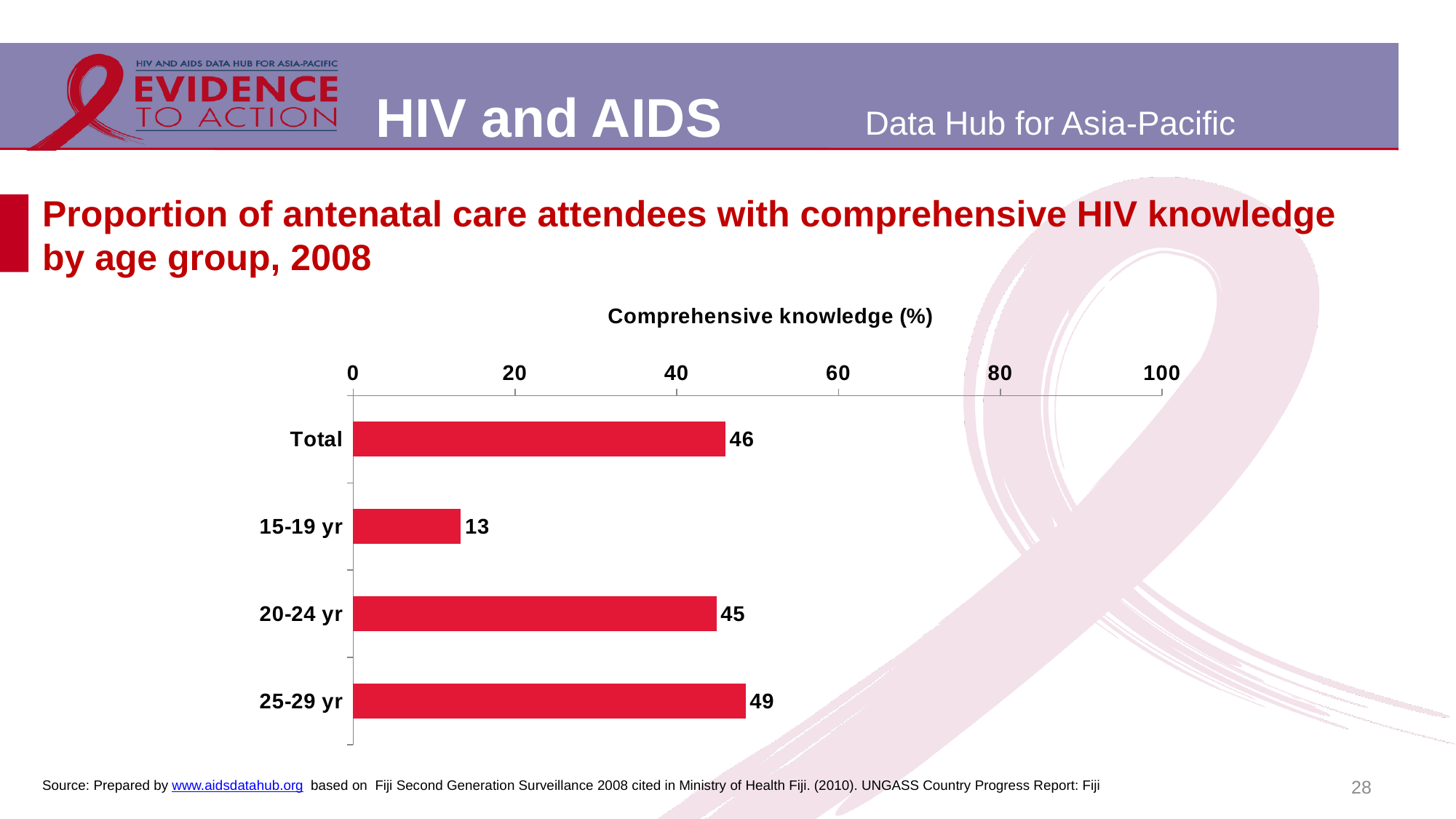
What is the difference between the values for 25-29 yr and 15-19 yr? 36 What is the value shown for Total? 46 What is the comprehensive knowledge value for the 25-29 yr age group? 49 What kind of chart is shown on the slide? Bar chart What is the comprehensive knowledge value for the 15-19 yr age group? 13 Which is larger, the value for 20-24 yr or the value for 15-19 yr? 20-24 yr How many categories are plotted in the chart? 4 Is the value for Total greater or less than 40? greater What is the axis title shown above the chart? Comprehensive knowledge (%) Which category has the highest comprehensive knowledge value? 25-29 yr Which category has the lowest comprehensive knowledge value? 15-19 yr What is the value shown for the 20-24 yr age group? 45